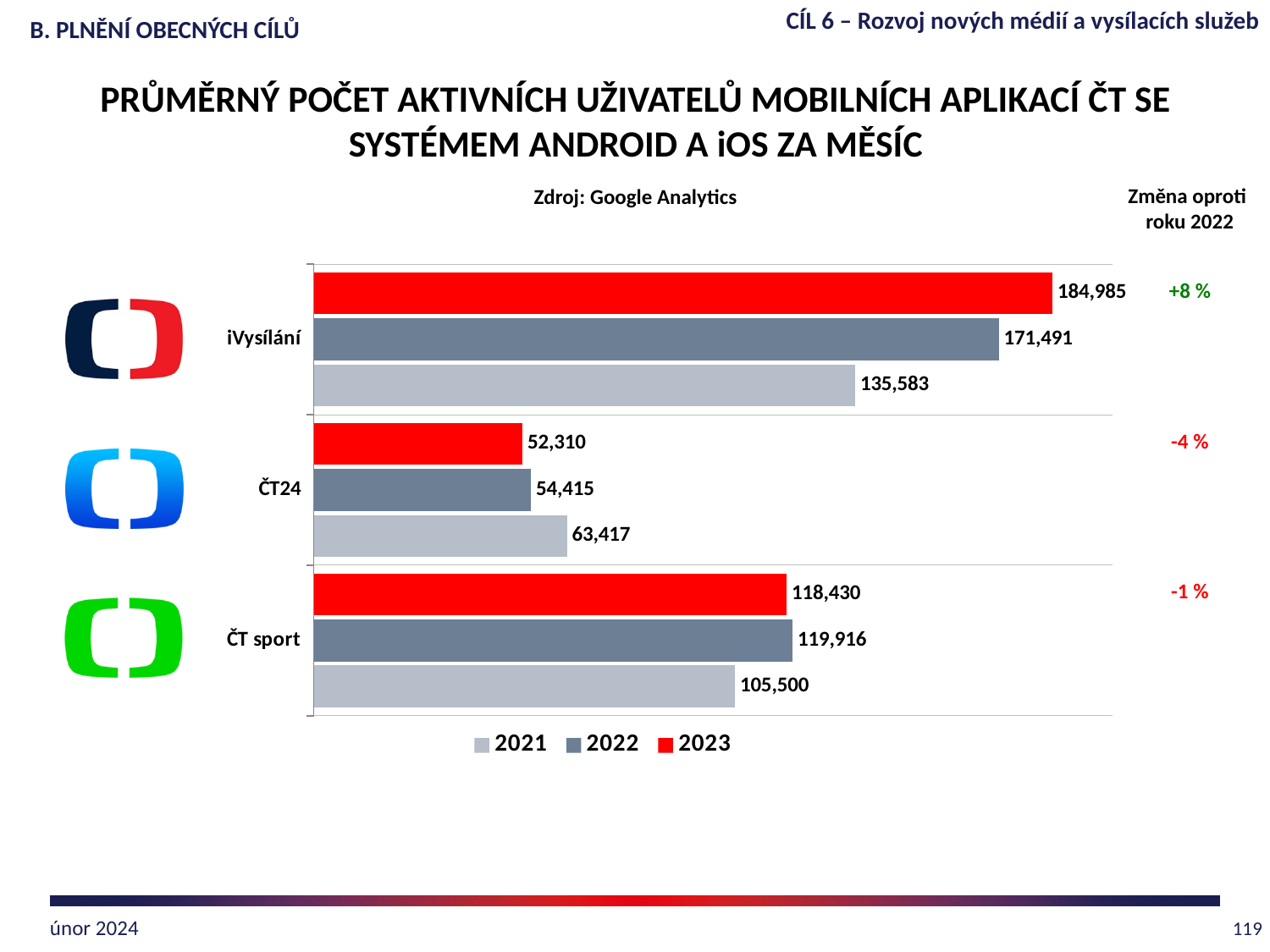
What is the value for iVysílání in 2023? 184,985 What is the value for ČT sport in 2022? 119,916 What is the difference between the 2023 and 2022 values for iVysílání? 13,494 How many series does the legend list? 3 Which is larger for ČT24: the 2022 value or the 2023 value? 2022 What is the source of the data shown on the chart? Google Analytics How many categories are shown on the chart? 3 What is the value for ČT24 in 2021? 63,417 What kind of chart is shown on the slide? bar chart Which category has the lowest value in 2021? ČT24 Which category has the highest value in 2023? iVysílání Do the values for ČT24 rise or fall from 2021 to 2023? fall